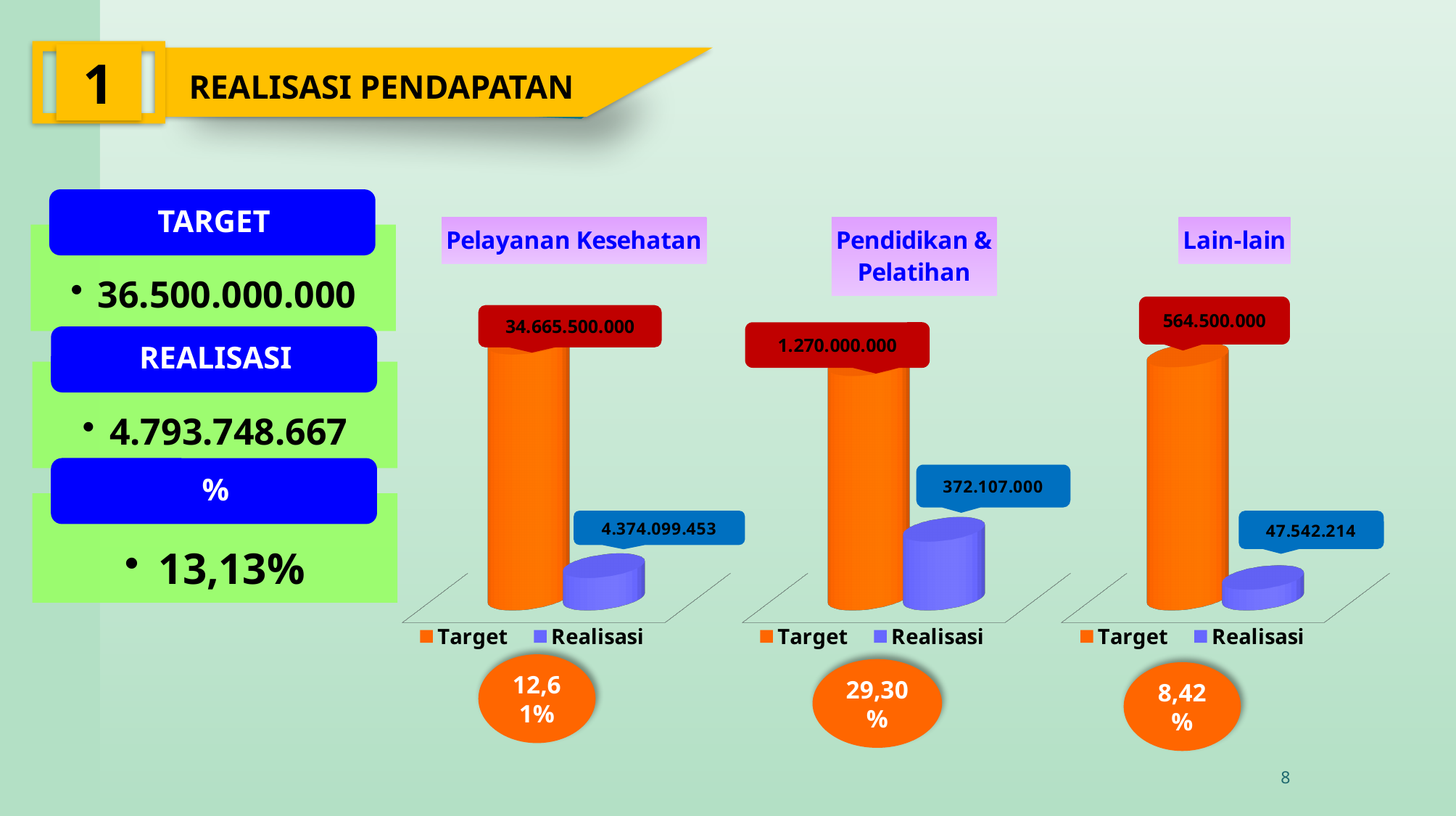
In the Pelayanan Kesehatan chart, what colour is the Realisasi bar? Blue (purple-blue) In the Lain-lain chart, what is the value of the Target bar? 564.500.000 In the Pelayanan Kesehatan chart, which is larger, Target or Realisasi? Target In the Pelayanan Kesehatan chart, what is the value of the Target bar? 34.665.500.000 In the Lain-lain chart, what is the value of the Realisasi bar? 47.542.214 In the Lain-lain chart, what is the difference between Target and Realisasi? 516.957.786 In the Pendidikan & Pelatihan chart, what is the difference between Target and Realisasi? 897.893.000 In the Pelayanan Kesehatan chart, what is the value of the Realisasi bar? 4.374.099.453 In the Pendidikan & Pelatihan chart, what is the value of the Target bar? 1.270.000.000 How many series does the legend of the Lain-lain chart list? 2 What type of chart is the Pendidikan & Pelatihan chart? Bar chart In the Pendidikan & Pelatihan chart, what is the value of the Realisasi bar? 372.107.000